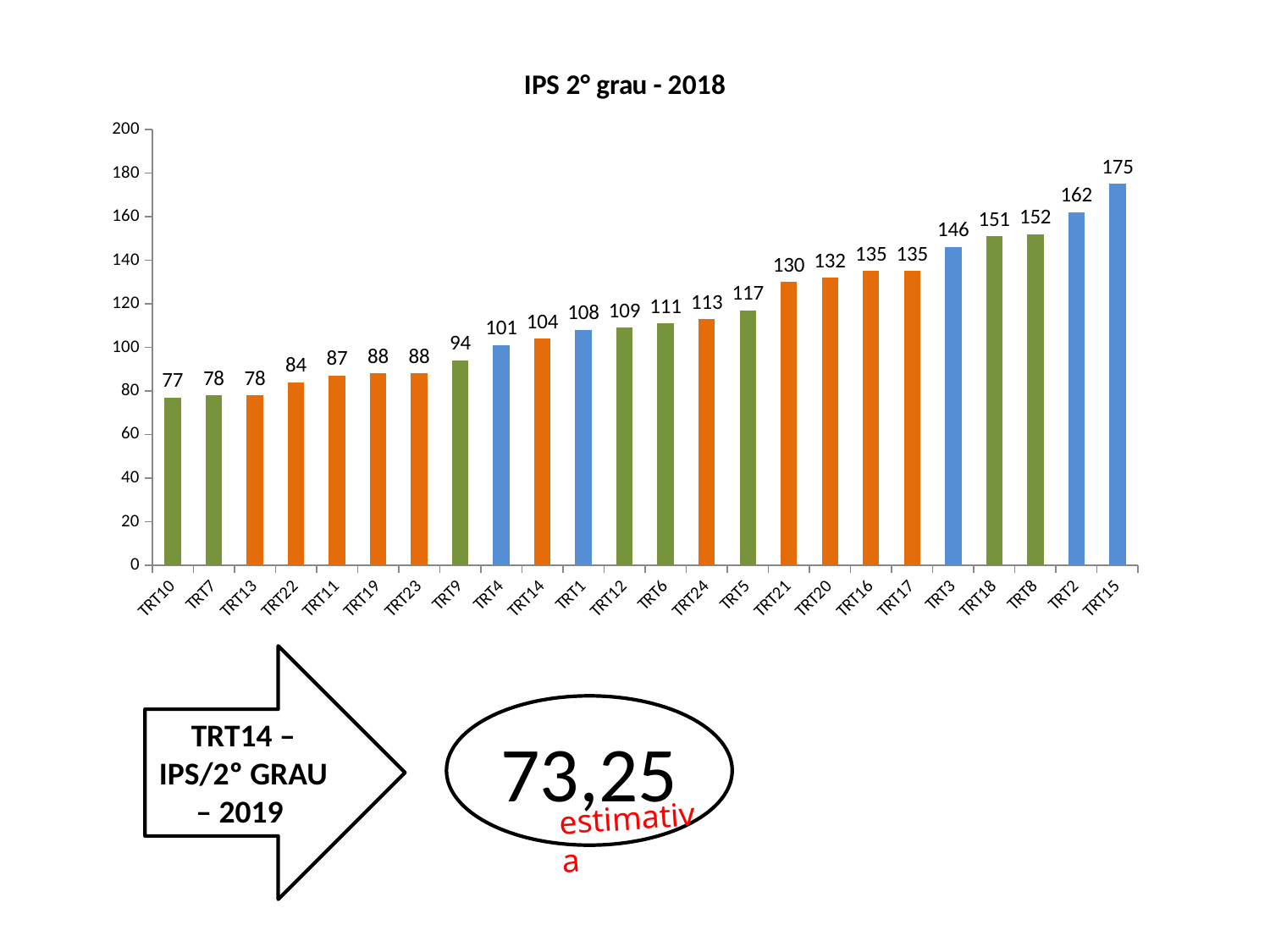
Which category has the highest value in the chart? TRT15 What is the value for TRT14 in the chart? 104 What is the difference between the values for TRT15 and TRT10? 98 What is the title of the chart? IPS 2° grau - 2018 What kind of chart is shown on the slide? Bar chart What is the value for TRT9 in the chart? 94 Is the value for TRT18 greater or less than 140? greater Which has a larger value, TRT5 or TRT20? TRT20 What is the value for TRT21 in the chart? 130 Which category has the lowest value in the chart? TRT10 What is the difference between the values for TRT2 and TRT3? 16 How many categories (bars) are shown in the chart? 24